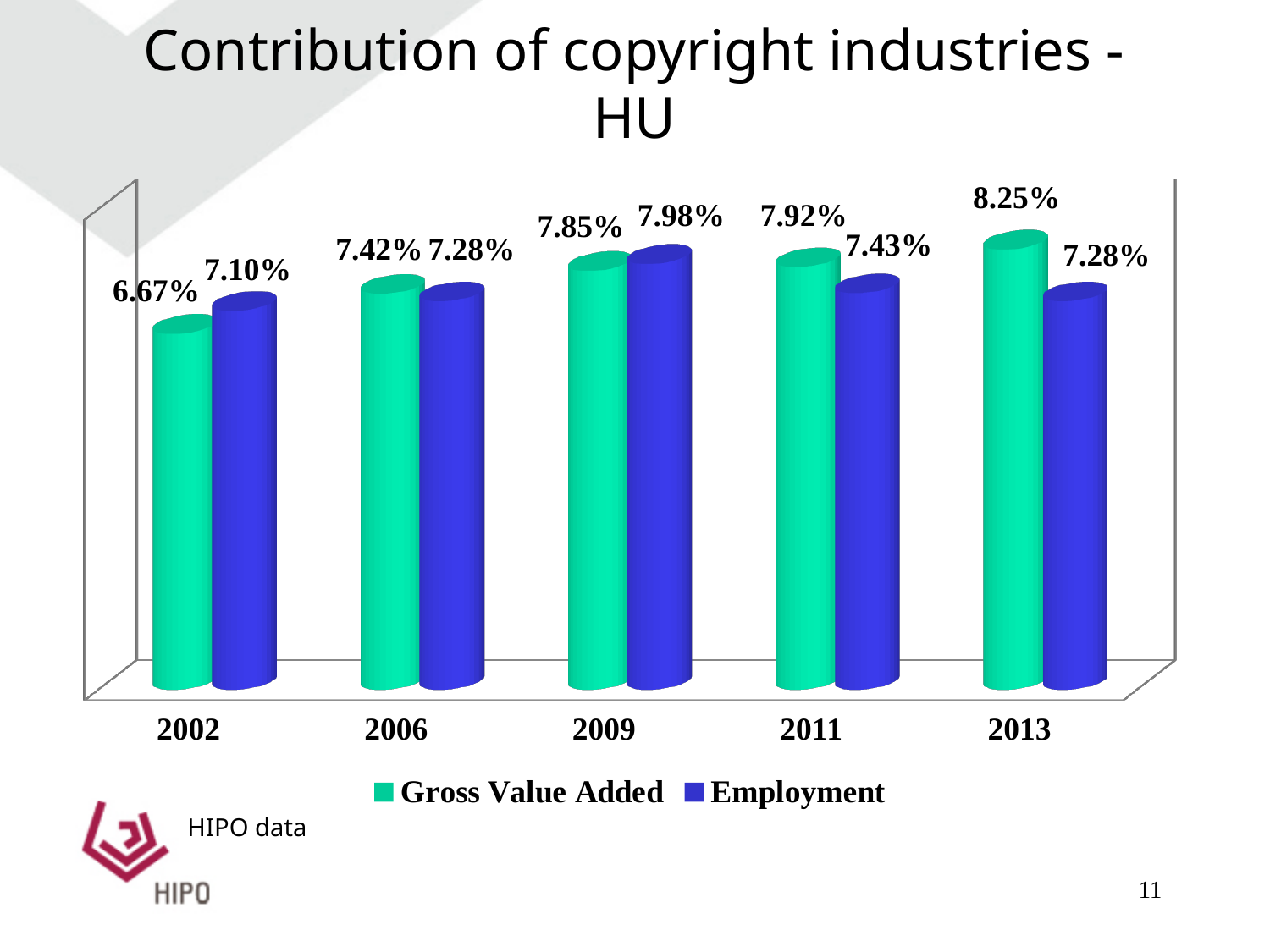
How many series does the legend list? 2 What kind of chart is shown on the slide? Bar chart What is the Employment value for 2009? 7.98% How many years are shown on the x axis? 5 What is the Gross Value Added value for 2013? 8.25% What is the Gross Value Added value for 2002? 6.67% Which year has the highest Gross Value Added value? 2013 Does the Gross Value Added series rise or fall from 2002 to 2013? Rise Which year has the lowest Employment value? 2002 In 2009, which is larger: Gross Value Added or Employment? Employment What is the difference between the Gross Value Added and Employment values in 2013? 0.97% Which colour represents the Employment series? Blue